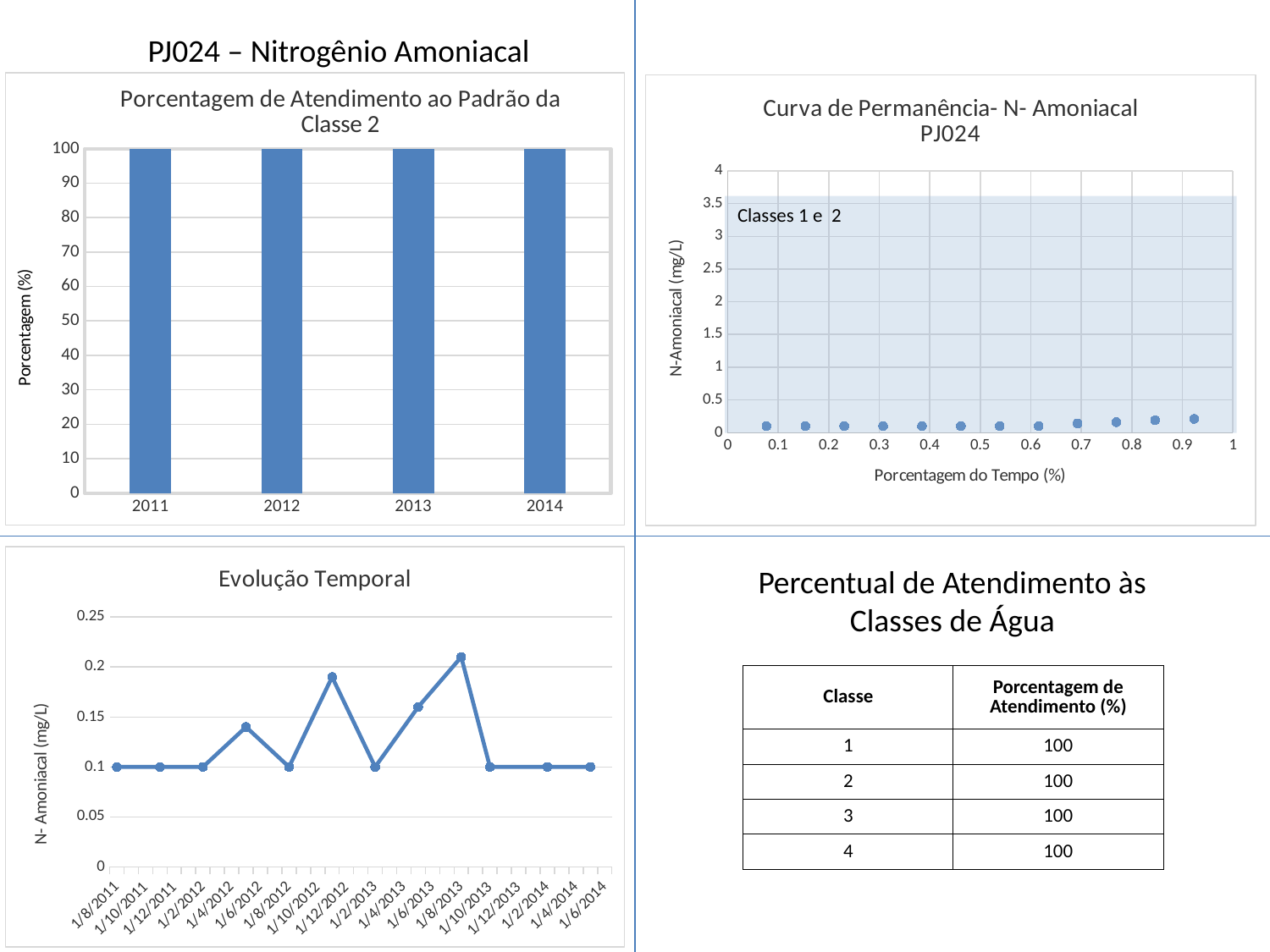
What is the y-axis label of the chart titled 'Porcentagem de Atendimento ao Padrão da Classe 2'? Porcentagem (%) In the chart titled 'Porcentagem de Atendimento ao Padrão da Classe 2', what is the value for 2014? 100 What is the x-axis label of the chart titled 'Curva de Permanência- N- Amoniacal PJ024'? Porcentagem do Tempo (%) In the chart titled 'Porcentagem de Atendimento ao Padrão da Classe 2', what is the value for 2012? 100 In the chart titled 'Porcentagem de Atendimento ao Padrão da Classe 2', is the value for 2013 larger than, smaller than, or equal to the value for 2011? equal How many years are shown on the x axis of the chart titled 'Porcentagem de Atendimento ao Padrão da Classe 2'? 4 What kind of chart is the one titled 'Porcentagem de Atendimento ao Padrão da Classe 2'? bar chart In the chart titled 'Curva de Permanência- N- Amoniacal PJ024', are all the plotted points greater or less than 0.5 mg/L? less What kind of chart is the one titled 'Evolução Temporal'? line chart How many data points are plotted in the chart titled 'Curva de Permanência- N- Amoniacal PJ024'? 12 In the chart titled 'Evolução Temporal', what is the value at 1/8/2011? 0.1